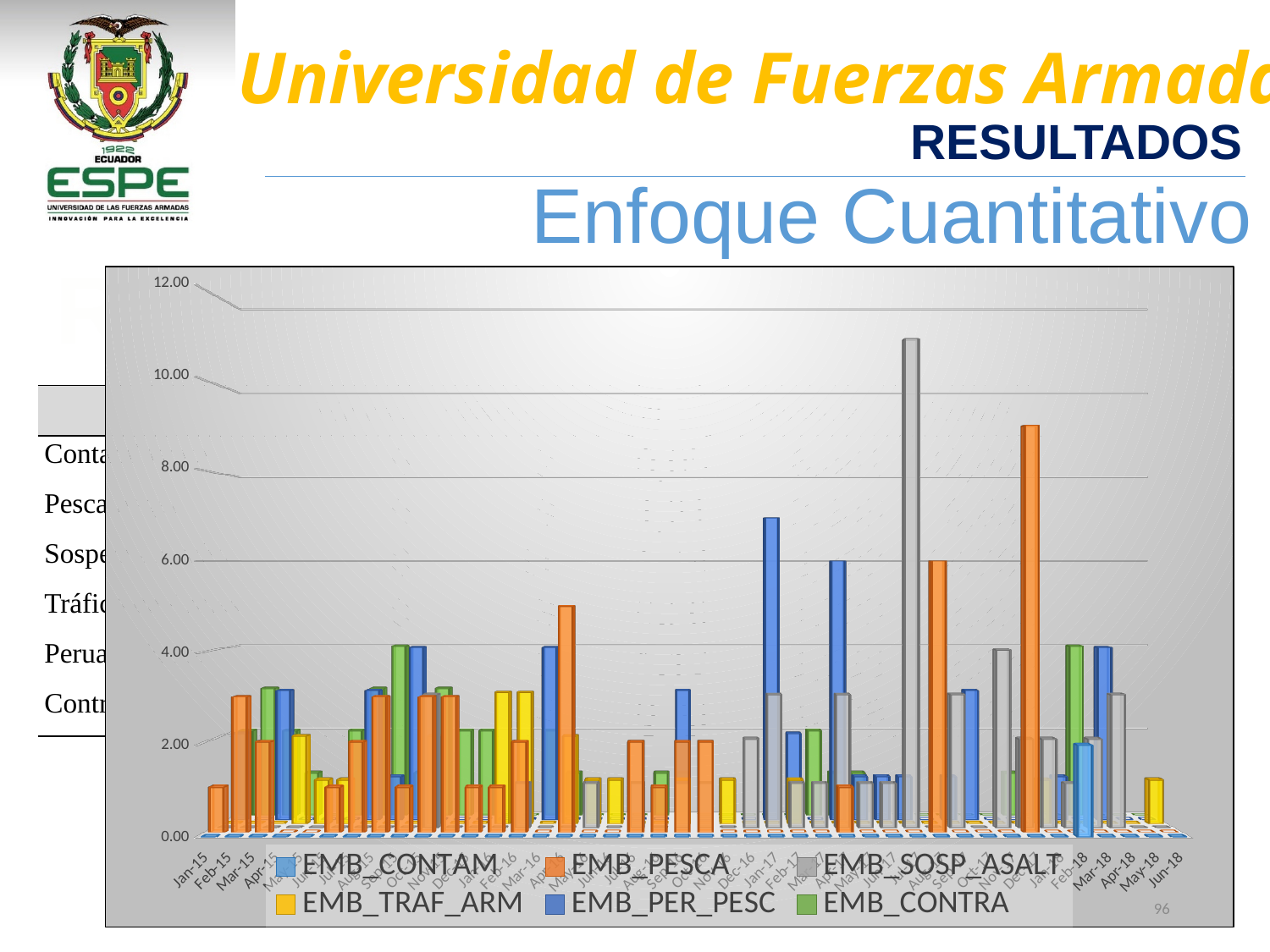
What colour represents the EMB_PESCA series in the chart? orange Is the tallest EMB_TRAF_ARM bar greater or less than 4.00? less Which series has the tallest bar in the chart? EMB_SOSP_ASALT How many series does the chart's legend list? 6 Which is taller: the tallest EMB_SOSP_ASALT bar or the tallest EMB_PESCA bar? EMB_SOSP_ASALT What is the highest value shown on the chart's vertical axis? 12.00 Is the tallest EMB_SOSP_ASALT bar greater or less than 10.00? greater What kind of chart is shown on the slide? bar chart Is the tallest EMB_PER_PESC bar greater or less than 6.00? greater Which is taller: the tallest EMB_PESCA bar or the tallest EMB_PER_PESC bar? EMB_PESCA